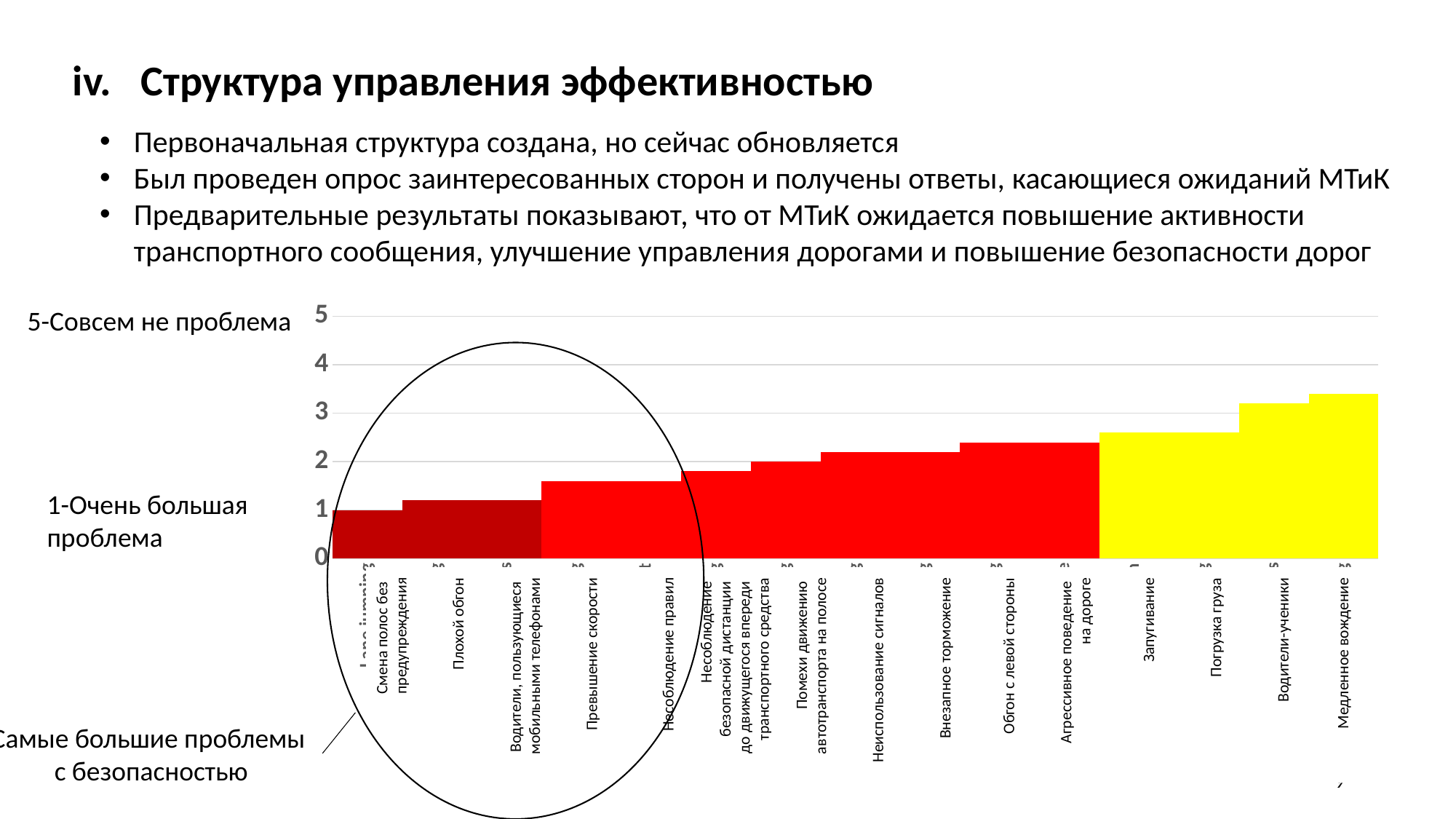
What is the highest value shown on the y axis of the chart? 5 Do the bar values rise or fall from left to right along the x axis? rise Is the value for Смена полос без предупреждения greater or less than 2? less What kind of chart is shown on the slide? bar chart How many categories are plotted along the x axis of the chart? 15 Is the value for Запугивание greater or less than 2? greater Is the value for Медленное вождение greater or less than 3? greater Which category has the lowest bar in the chart? Смена полос без предупреждения What colour are the bars on the right side of the chart, from Запугивание to Медленное вождение? yellow Which category has the highest bar in the chart? Медленное вождение Which is larger, the value for Медленное вождение or the value for Плохой обгон? Медленное вождение